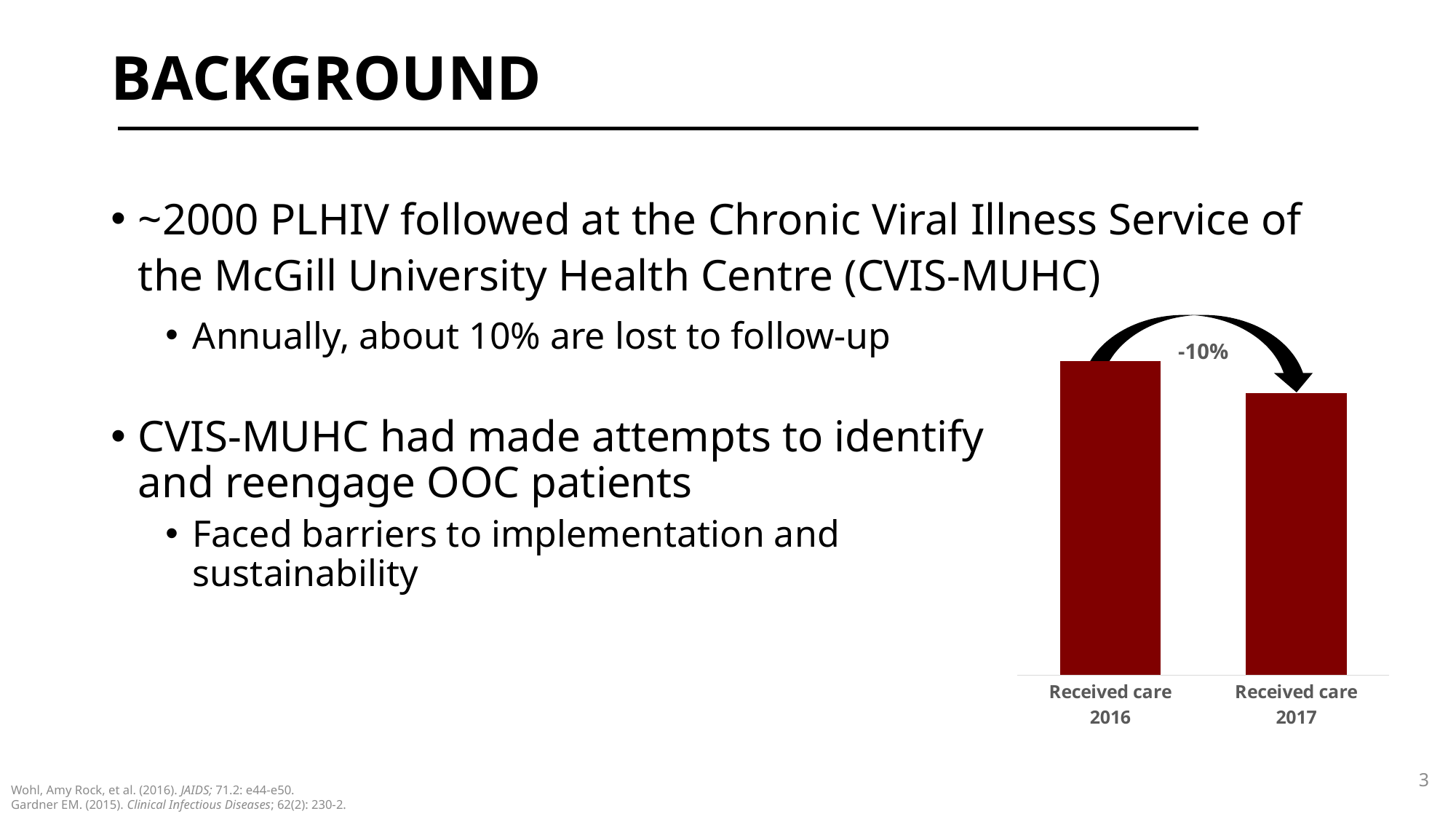
What percentage change is labelled on the arrow between the two bars? -10% What kind of chart is shown on the slide? bar chart What colour are the bars in the chart? dark red What is the label of the first bar on the chart? Received care 2016 How many bars does the chart show? 2 Which category has the highest bar in the chart? Received care 2016 Which category has the lowest bar in the chart? Received care 2017 What is the label of the second bar on the chart? Received care 2017 Which category has the taller bar, Received care 2016 or Received care 2017? Received care 2016 Do the bar values rise or fall from 2016 to 2017? fall